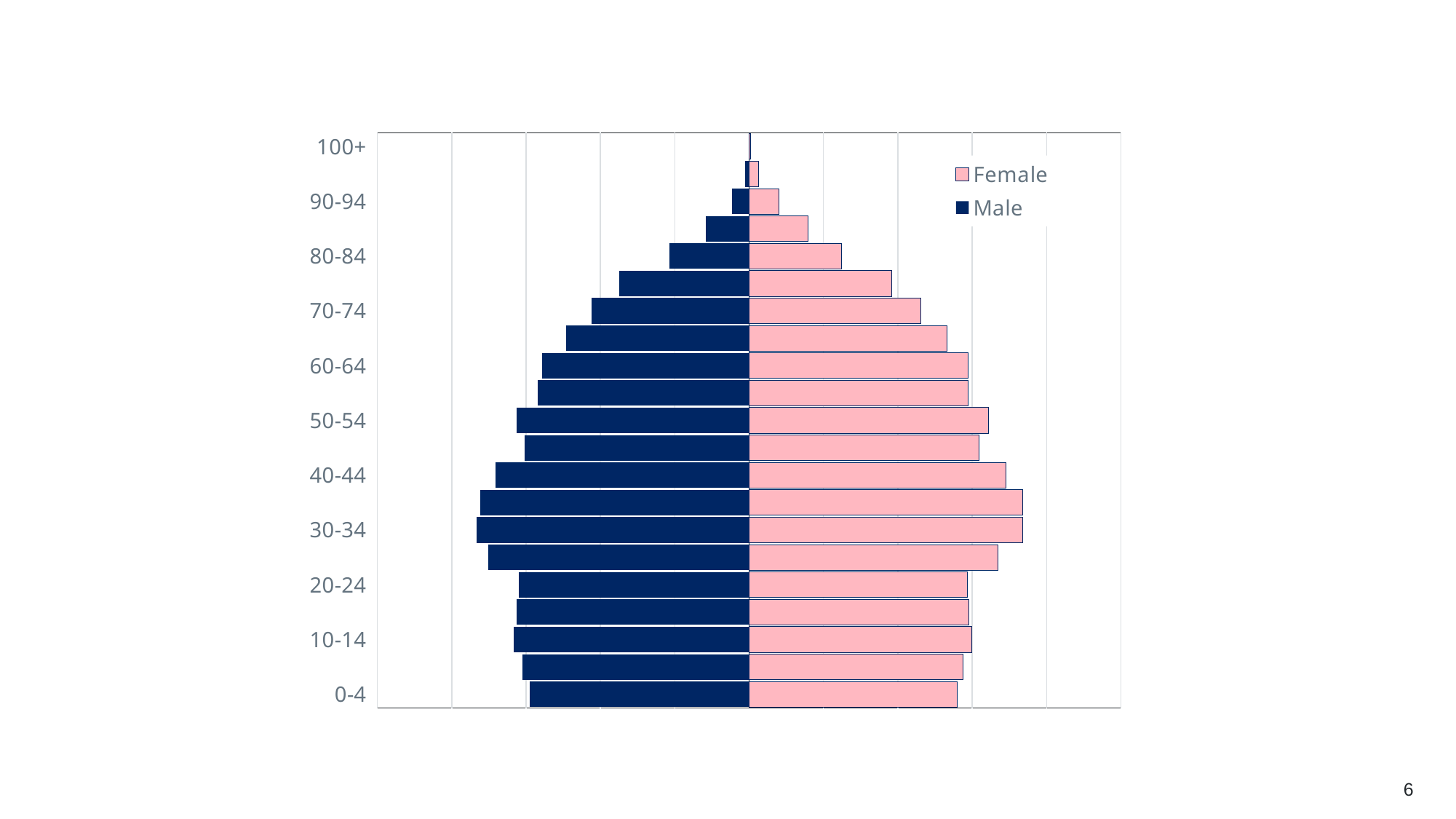
Is the Female bar for 80-84 longer or shorter than the Female bar for 40-44? shorter Which age group has the smallest bars for both Male and Female? 100+ Do the bar lengths rise or fall as the age groups go from 60-64 up to 100+? fall How many series does the legend list? 2 What kind of chart is shown on the slide? bar chart How many age-group bars are plotted for each series? 21 What are the two series named in the legend? Female and Male Which colour represents the Male series? dark navy blue Is the Male bar for 70-74 longer or shorter than the Male bar for 20-24? shorter Is the Male bar for 30-34 longer or shorter than the Male bar for 0-4? longer